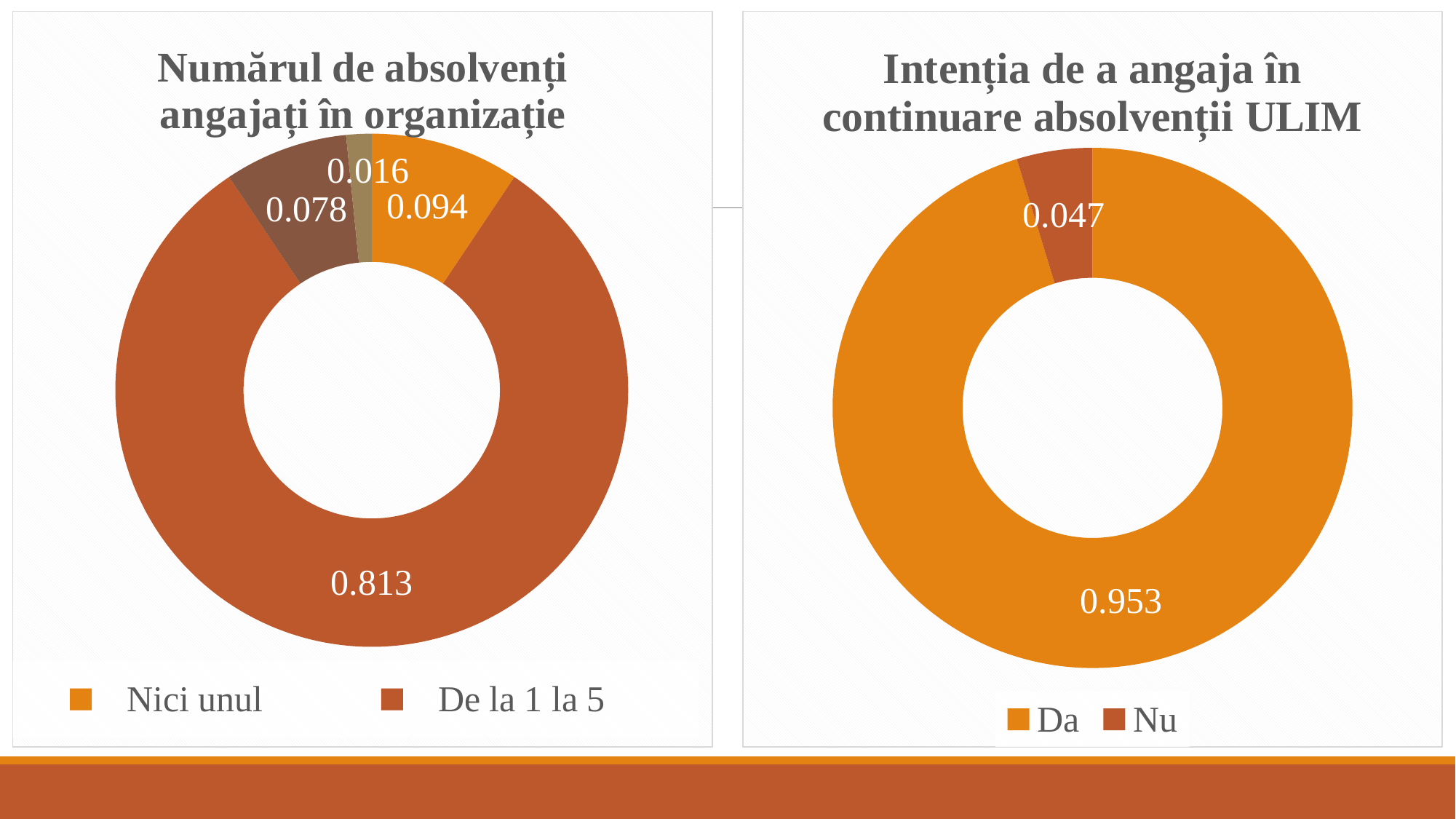
How many slices does the left chart have? 4 In the right chart, what is the difference between the values for "Da" and "Nu"? 0.906 In the chart titled "Intenția de a angaja în continuare absolvenții ULIM", what is the value for "Nu"? 0.047 In the chart titled "Intenția de a angaja în continuare absolvenții ULIM", what is the value for "Da"? 0.953 What is the smallest value labelled on the left chart? 0.016 In the chart titled "Numărul de absolvenți angajați în organizație", what is the value for "De la 1 la 5"? 0.813 In the left chart, what is the difference between the values for "De la 1 la 5" and "Nici unul"? 0.719 In the left chart, which is larger: "Nici unul" or "De la 1 la 5"? De la 1 la 5 In the chart titled "Numărul de absolvenți angajați în organizație", what is the value for "Nici unul"? 0.094 What kind of chart is the right chart? Doughnut chart In the right chart, which category has the smallest slice? Nu In the left chart, which category has the largest slice? De la 1 la 5